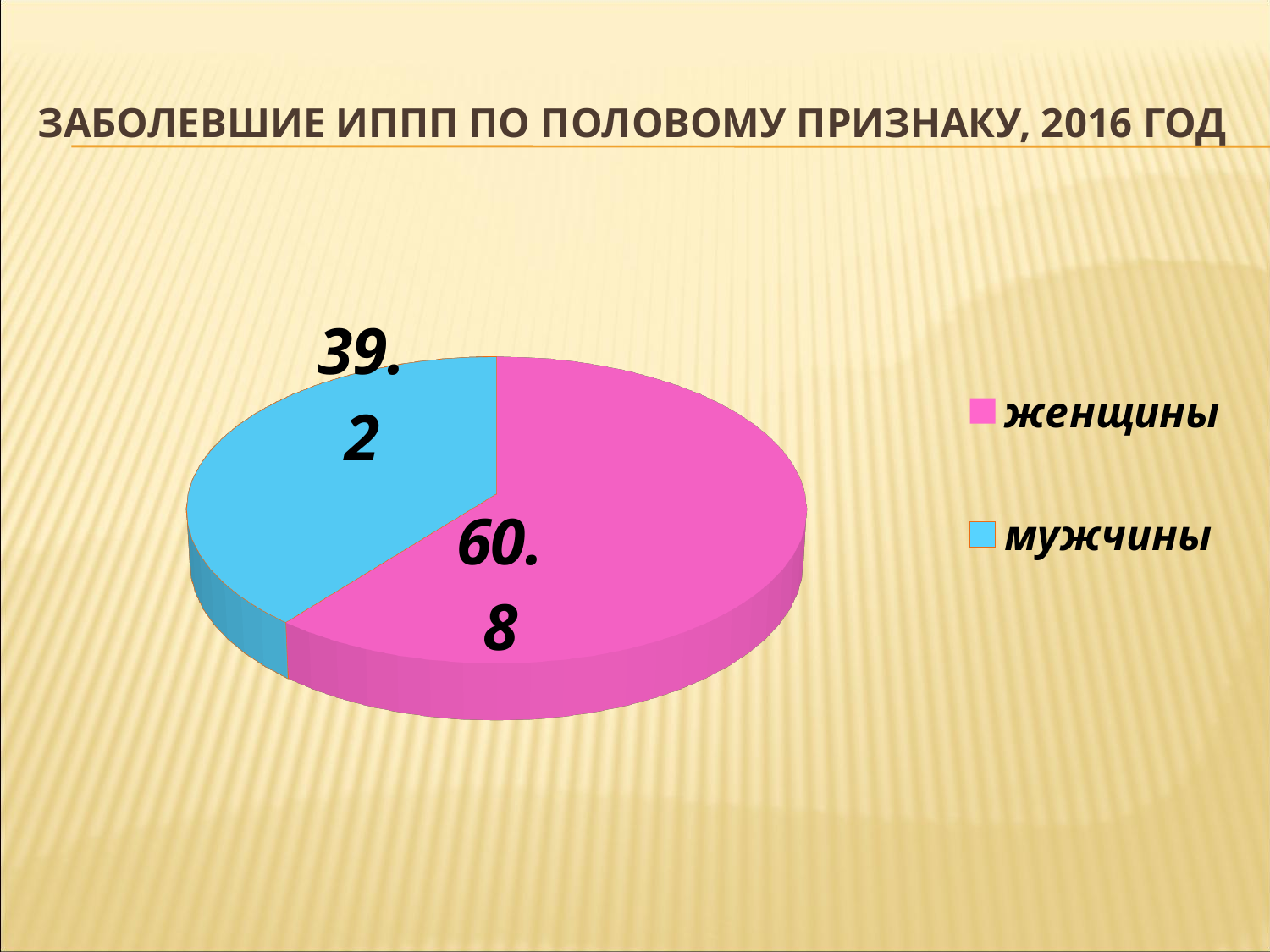
Which is larger, the value for женщины or the value for мужчины? женщины What is the difference between the values for женщины and мужчины? 21.6 What is the title of the chart on the slide? ЗАБОЛЕВШИЕ ИППП ПО ПОЛОВОМУ ПРИЗНАКУ, 2016 ГОД Which category has the largest slice of the pie chart? женщины What colour is the slice for мужчины? blue What is the total of the two values shown on the pie chart? 100 Which category has the smallest slice of the pie chart? мужчины What is the value shown for женщины on the pie chart? 60.8 How many slices does the pie chart have? 2 What is the value shown for мужчины on the pie chart? 39.2 What kind of chart is shown on the slide? pie chart How many entries does the legend list? 2